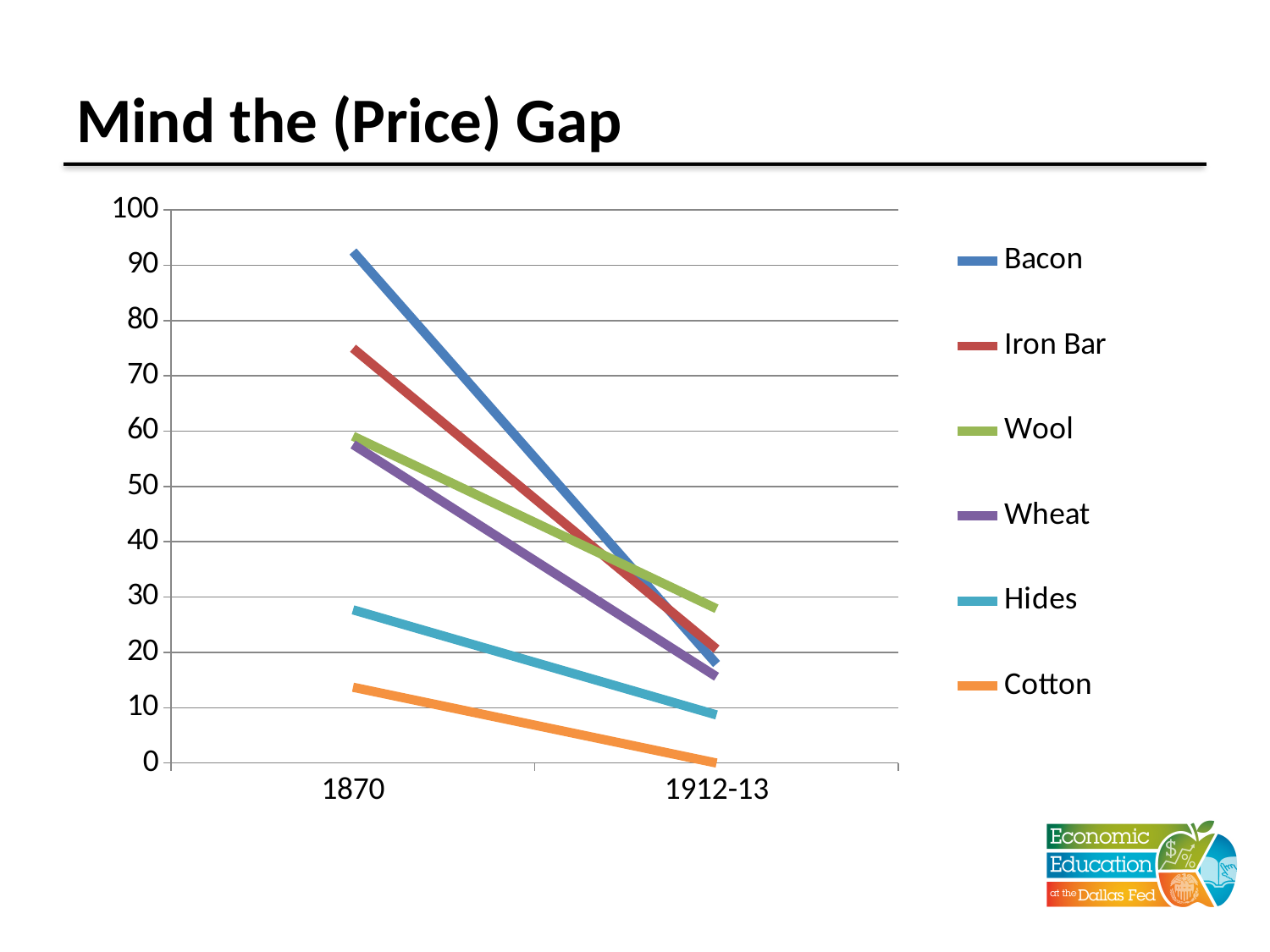
How many points are shown along the x axis? 2 How many series does the legend list? 6 Do the values for Bacon rise or fall from 1870 to 1912-13? fall Which series has the lowest value in 1870? Cotton Which series has the highest value in 1912-13? Wool In 1870, which is larger, Iron Bar or Wool? Iron Bar Is the value for Hides in 1870 greater or less than 40? less Is the value for Bacon in 1870 greater or less than 80? greater Which series has the lowest value in 1912-13? Cotton What kind of chart is shown on the slide? line chart Which series has the highest value in 1870? Bacon What is the title of the slide containing the chart? Mind the (Price) Gap